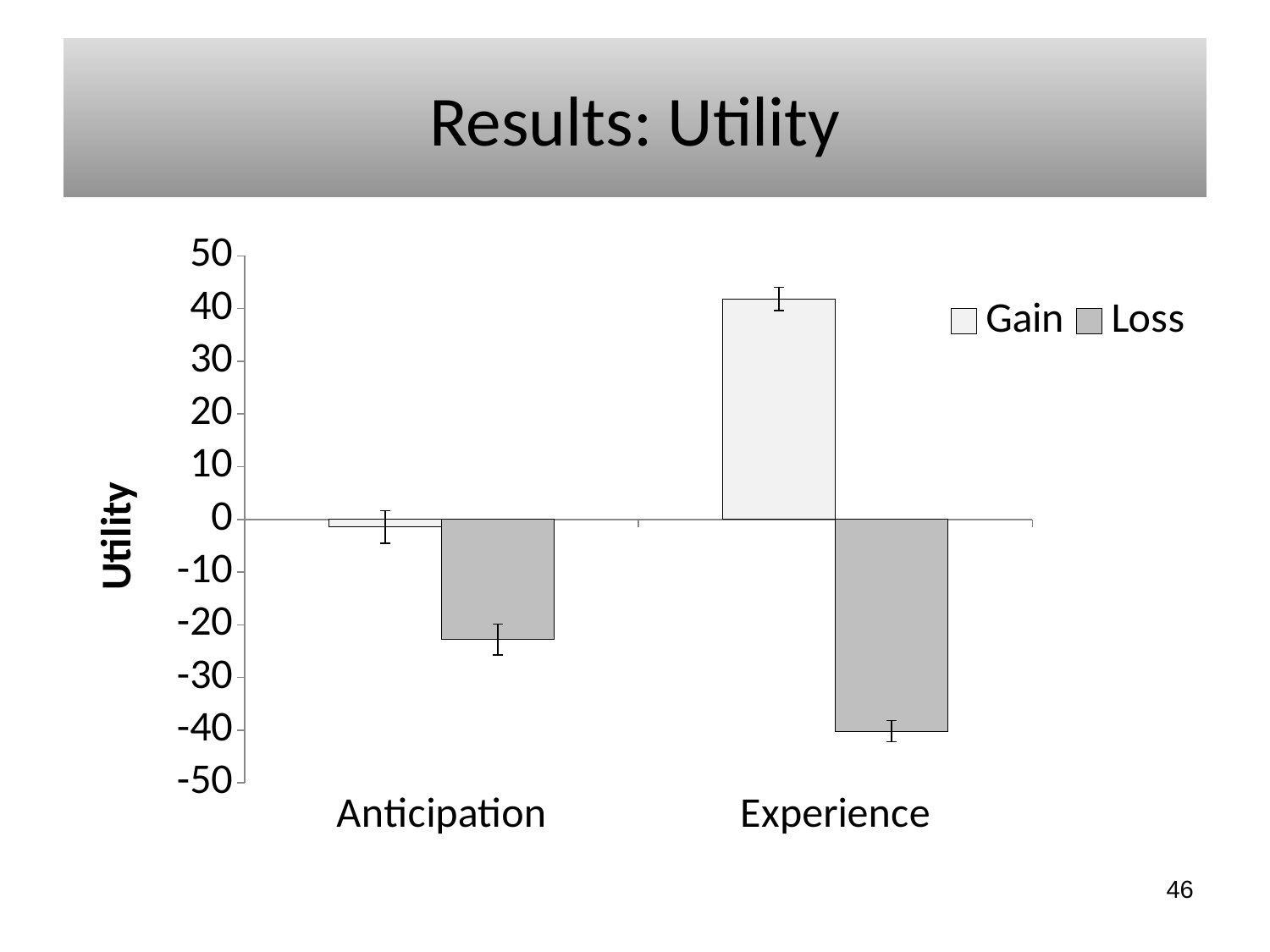
Is the Gain value for Experience greater or less than 30? greater Is the Loss value for Experience greater or less than -30? less Which series and category has the highest bar? Gain in Experience What is the title of the y axis? Utility Which is larger, the Gain value for Anticipation or the Gain value for Experience? Experience Is the Loss value for Anticipation greater or less than -30? greater How many series does the legend list? 2 How many categories are shown on the x axis? 2 Does the Loss series rise or fall from Anticipation to Experience? fall What kind of chart is shown on the slide? bar chart Which series and category has the lowest bar? Loss in Experience